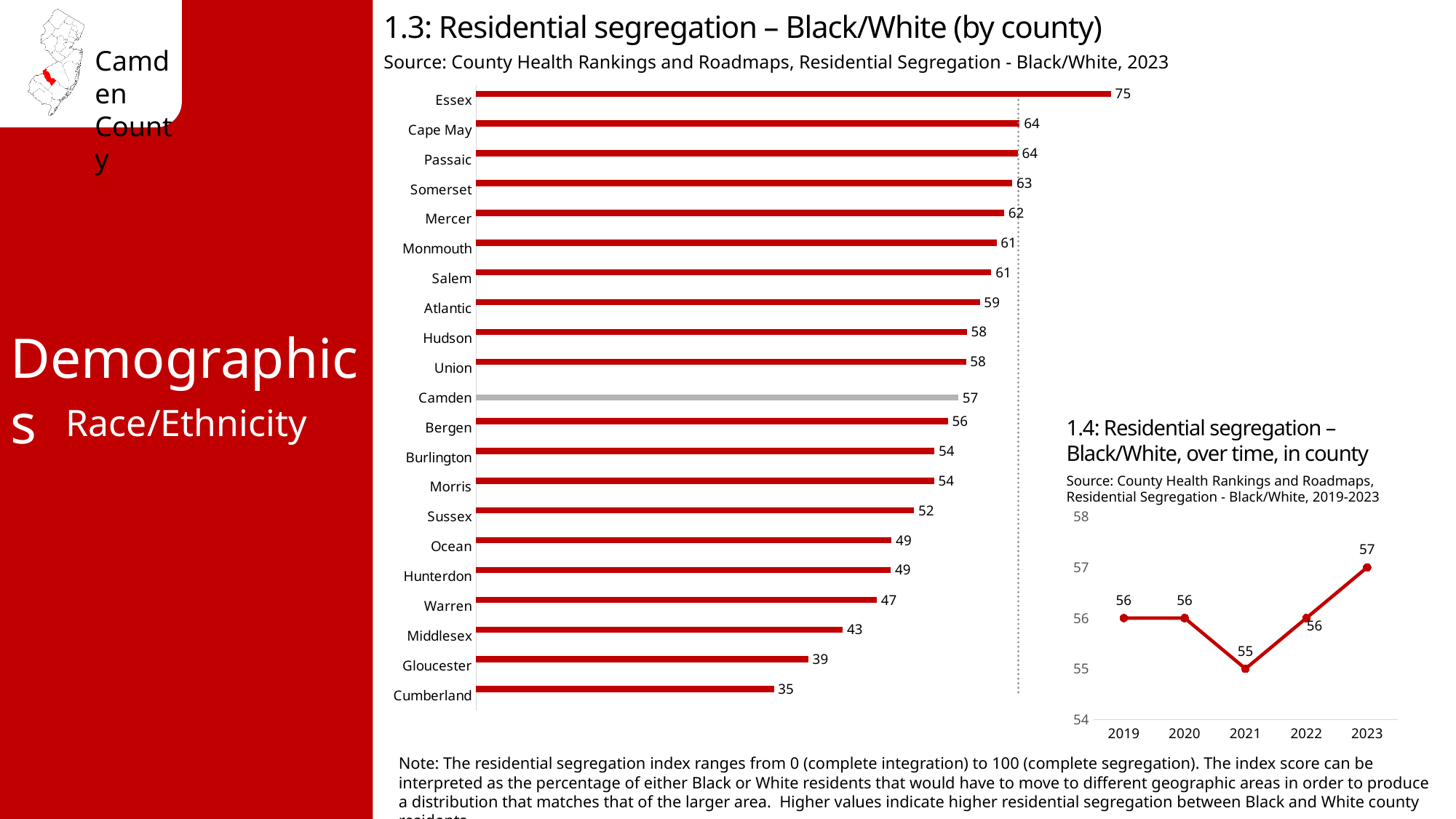
In chart 1.3 (by county), what is the difference between the values for Essex and Cumberland? 40 In chart 1.3 (by county), what is the value for Mercer? 62 In chart 1.3 (by county), which has a higher value, Middlesex or Gloucester? Middlesex In chart 1.3 (by county), how many counties are shown? 21 What kind of chart is chart 1.3 (Residential segregation – Black/White by county)? Bar chart In chart 1.3 (Residential segregation – Black/White by county), what is the value for Camden? 57 In chart 1.3 (by county), which county has the lowest residential segregation index? Cumberland In chart 1.4 (Residential segregation over time, in county), what is the value for 2021? 55 In chart 1.4 (over time, in county), which year has the highest value? 2023 What kind of chart is chart 1.4 (Residential segregation over time, in county)? Line chart In chart 1.4 (over time, in county), how many years are plotted? 5 In chart 1.3 (by county), which county has the highest residential segregation index? Essex